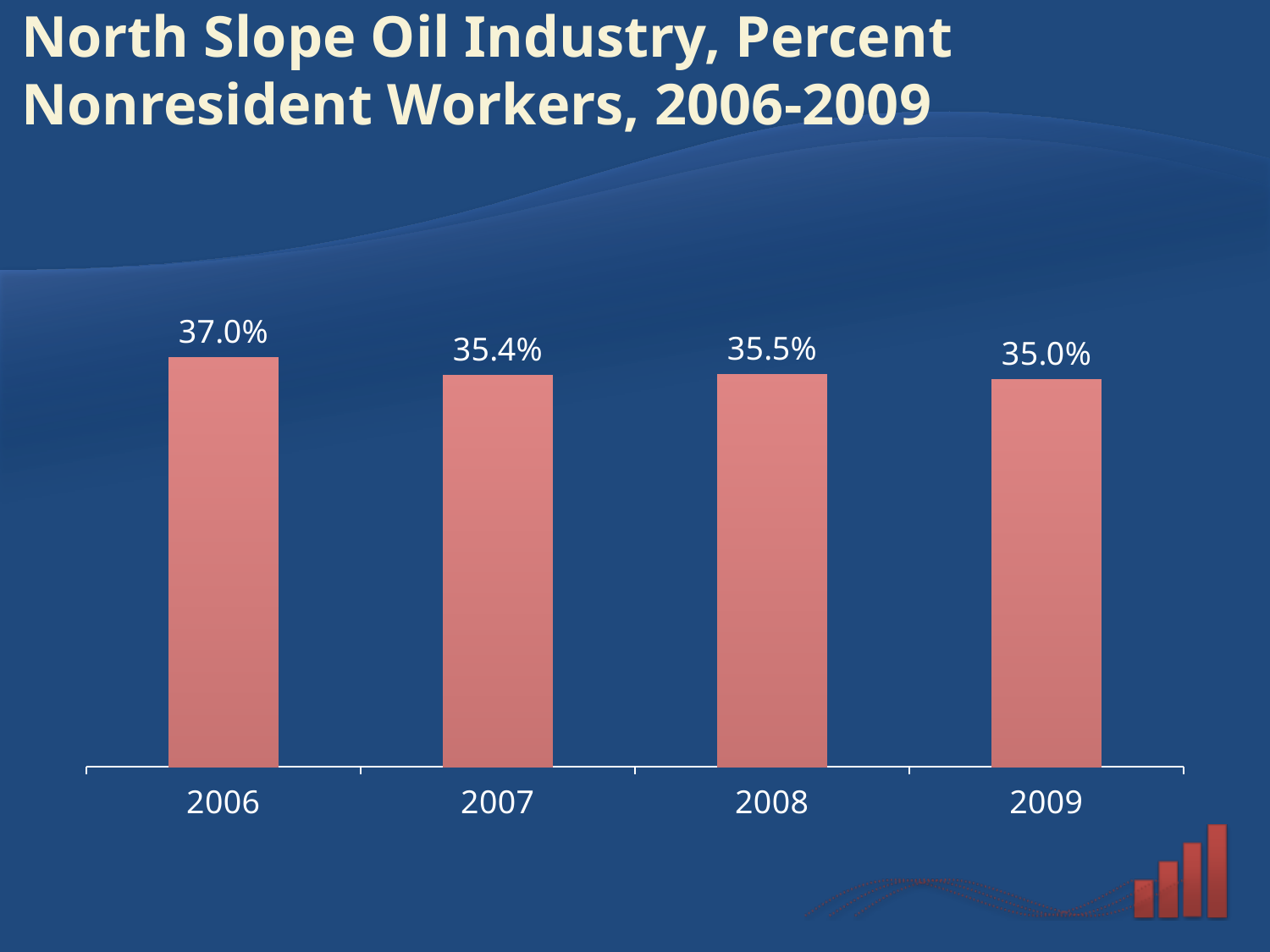
What kind of chart is shown on the slide? Bar chart What is the percent of nonresident workers in 2008? 35.5% Which year has a larger percent of nonresident workers, 2006 or 2008? 2006 Which year has the lowest percent of nonresident workers? 2009 What is the percent of nonresident workers in 2007? 35.4% What is the difference in percent nonresident workers between 2006 and 2007? 1.6% What is the title of the chart? North Slope Oil Industry, Percent Nonresident Workers, 2006-2009 How many years are shown on the chart? 4 Which year has the highest percent of nonresident workers? 2006 What is the difference in percent nonresident workers between 2006 and 2009? 2.0% What is the percent of nonresident workers in 2009? 35.0% What is the percent of nonresident workers in 2006? 37.0%